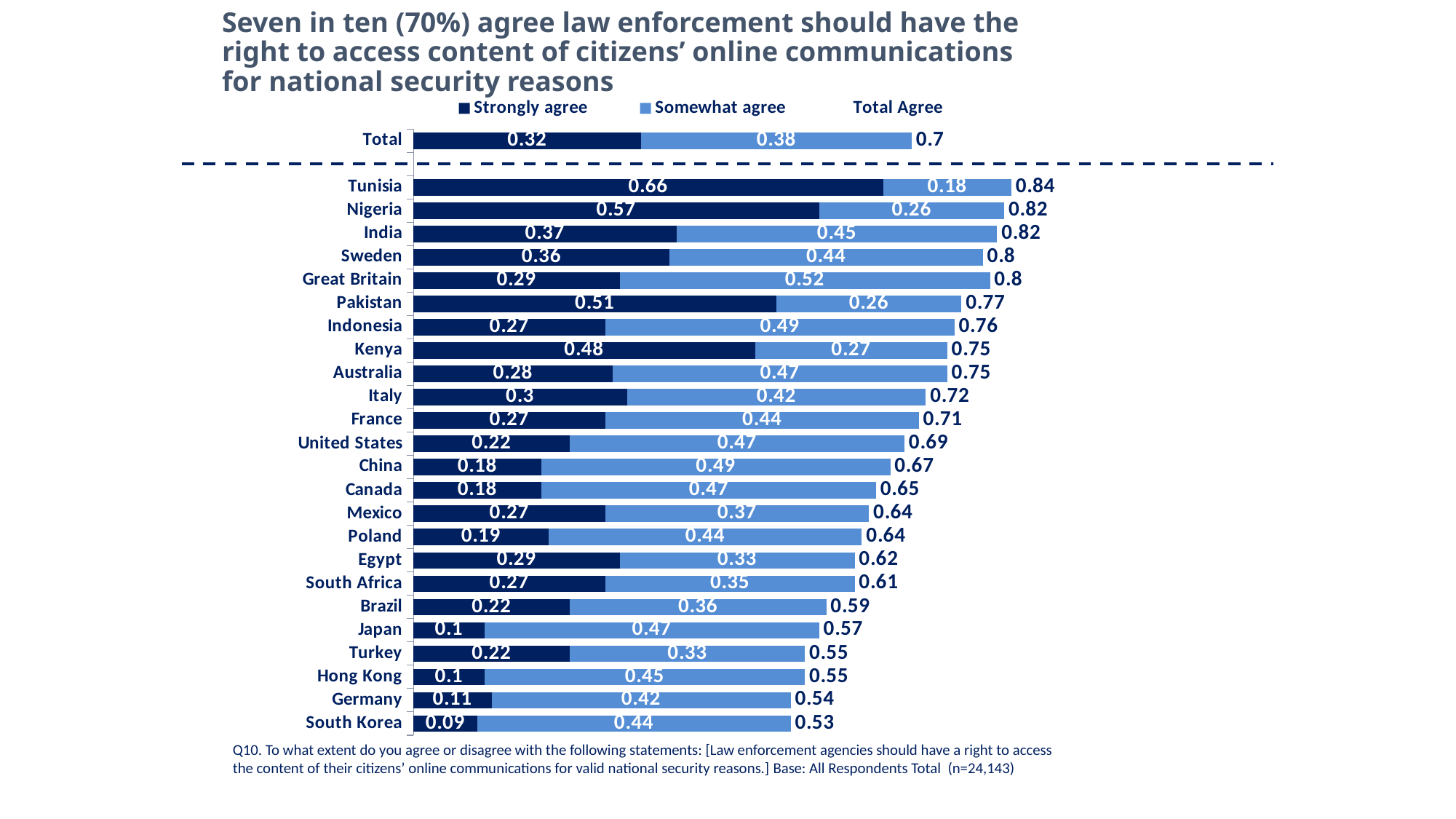
How many countries are listed below the dashed line in the chart? 24 What is the total of the stacked bar for Total (Strongly agree plus Somewhat agree)? 0.7 What is the Somewhat agree value for Great Britain? 0.52 What is the Total Agree value for Japan? 0.57 How many entries does the legend list? 3 What is the difference between the Total Agree values for Tunisia and South Korea? 0.31 Which colour represents Strongly agree in the chart? Dark blue Which country has the highest Total Agree value? Tunisia Which country has the lowest Strongly agree value? South Korea Which has a larger Strongly agree value, Pakistan or Kenya? Pakistan What is the Strongly agree value for Tunisia? 0.66 What kind of chart is shown on the slide? Stacked bar chart